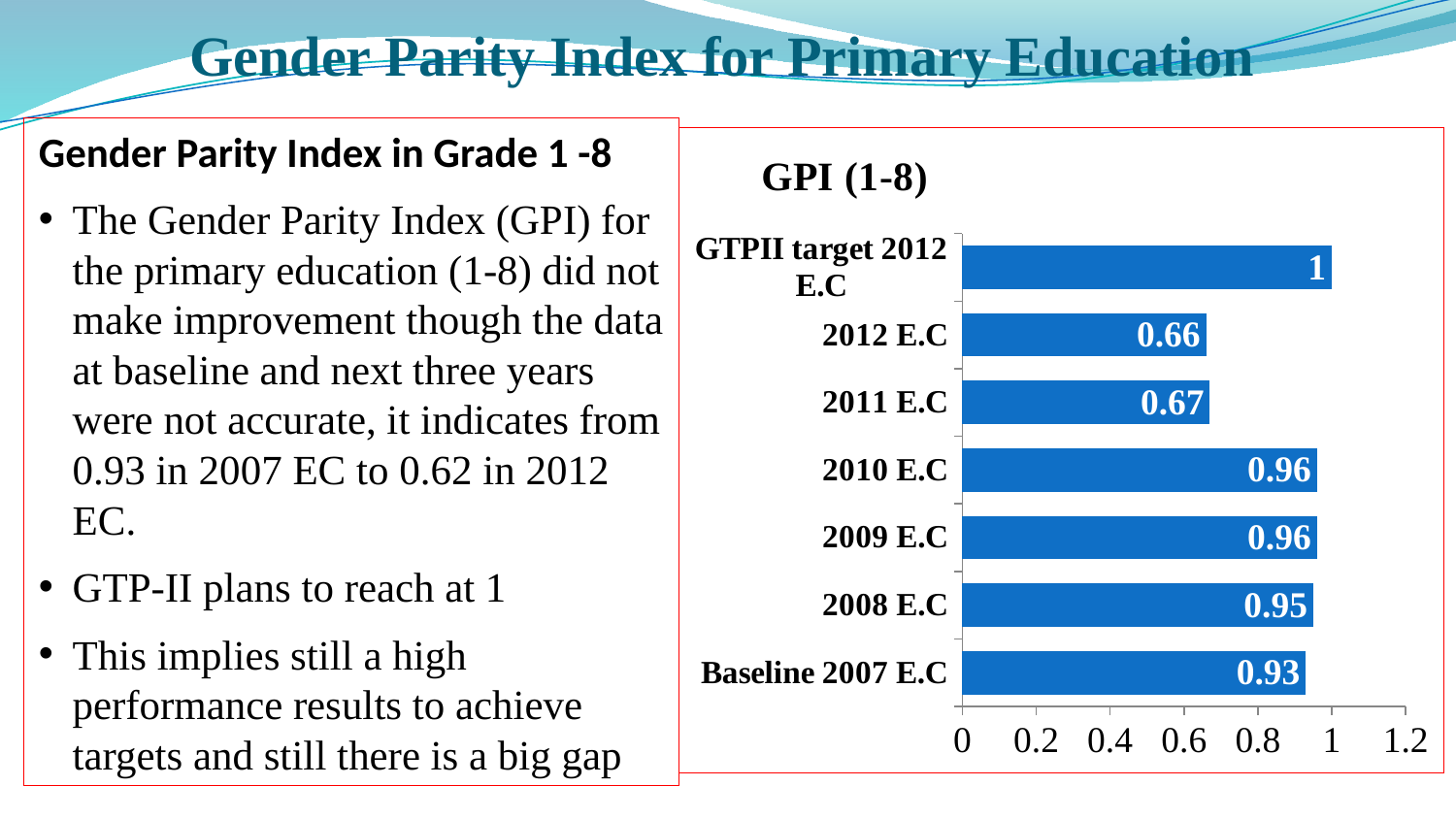
What is the value for 2008 E.C in the GPI (1-8) chart? 0.95 Which category has the lowest value in the GPI (1-8) chart? 2012 E.C Which is larger in the GPI (1-8) chart, the value for 2010 E.C or the value for 2011 E.C? 2010 E.C What is the value for GTPII target 2012 E.C in the GPI (1-8) chart? 1 What is the value for 2012 E.C in the GPI (1-8) chart? 0.66 Which category has the highest value in the GPI (1-8) chart? GTPII target 2012 E.C What kind of chart is the GPI (1-8) chart? bar chart Is the value for 2011 E.C in the GPI (1-8) chart greater or less than 0.8? less What is the title of the chart on the slide? GPI (1-8) How many categories are shown in the GPI (1-8) chart? 7 What is the difference between the GTPII target 2012 E.C value and the 2012 E.C value in the GPI (1-8) chart? 0.34 What is the value for Baseline 2007 E.C in the GPI (1-8) chart? 0.93